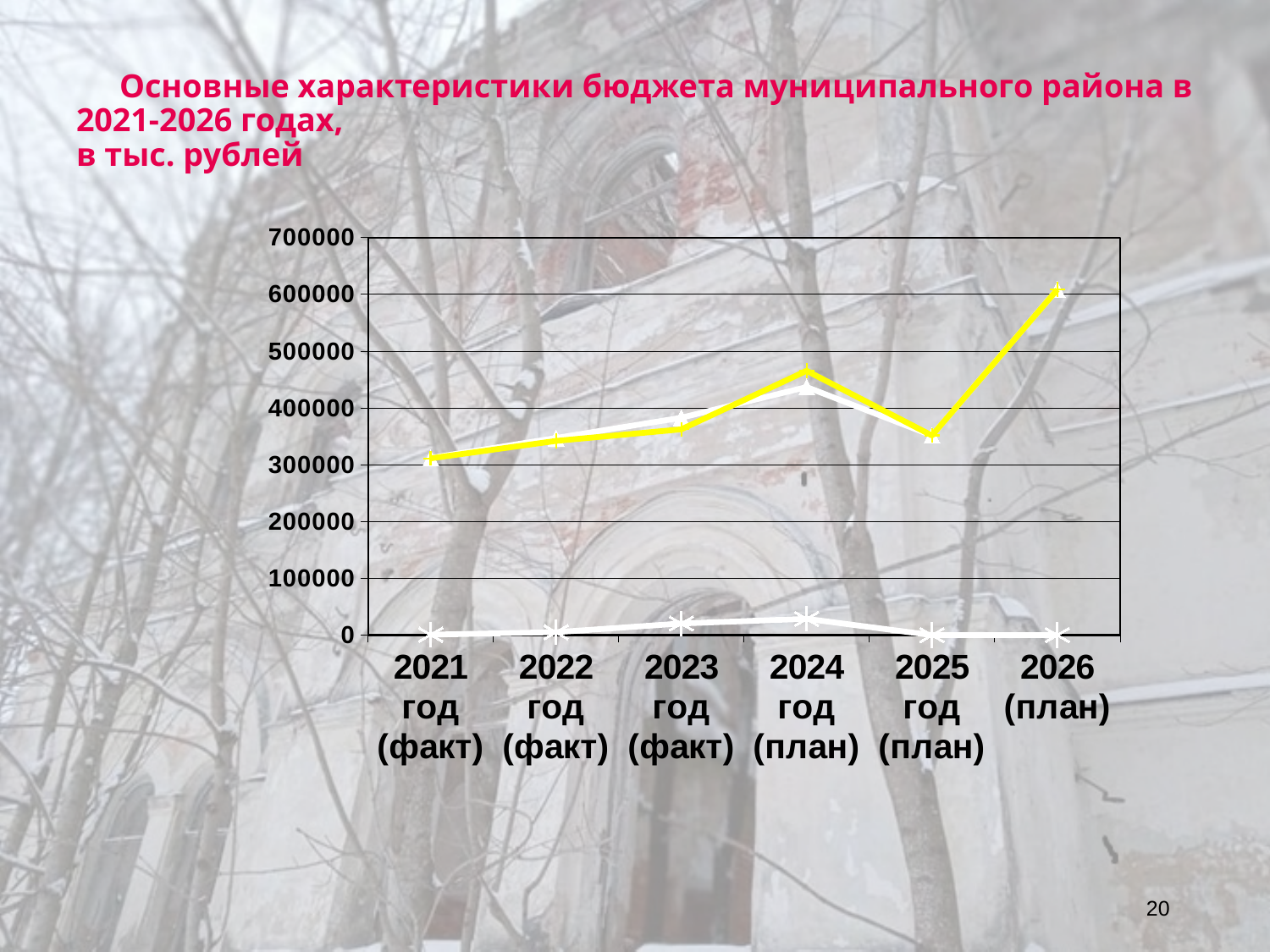
Is the value of the yellow line for 2024 год (план) greater or less than 400000? greater In which year does the yellow line have its lowest value? 2021 год (факт) How many years (categories) are shown on the x axis of the chart? 6 In which year does the yellow line reach its highest value? 2026 (план) What is the unit of measurement stated in the slide title? тыс. рублей Is the value of the lowest white line (with x markers) for 2024 год (план) greater or less than 100000? less Is the value of the yellow line for 2021 год (факт) greater or less than 400000? less Does the yellow line rise or fall from 2021 год (факт) to 2024 год (план)? rise For the yellow line, which year has the larger value: 2023 год (факт) or 2024 год (план)? 2024 год (план) What kind of chart is shown on the slide? line chart